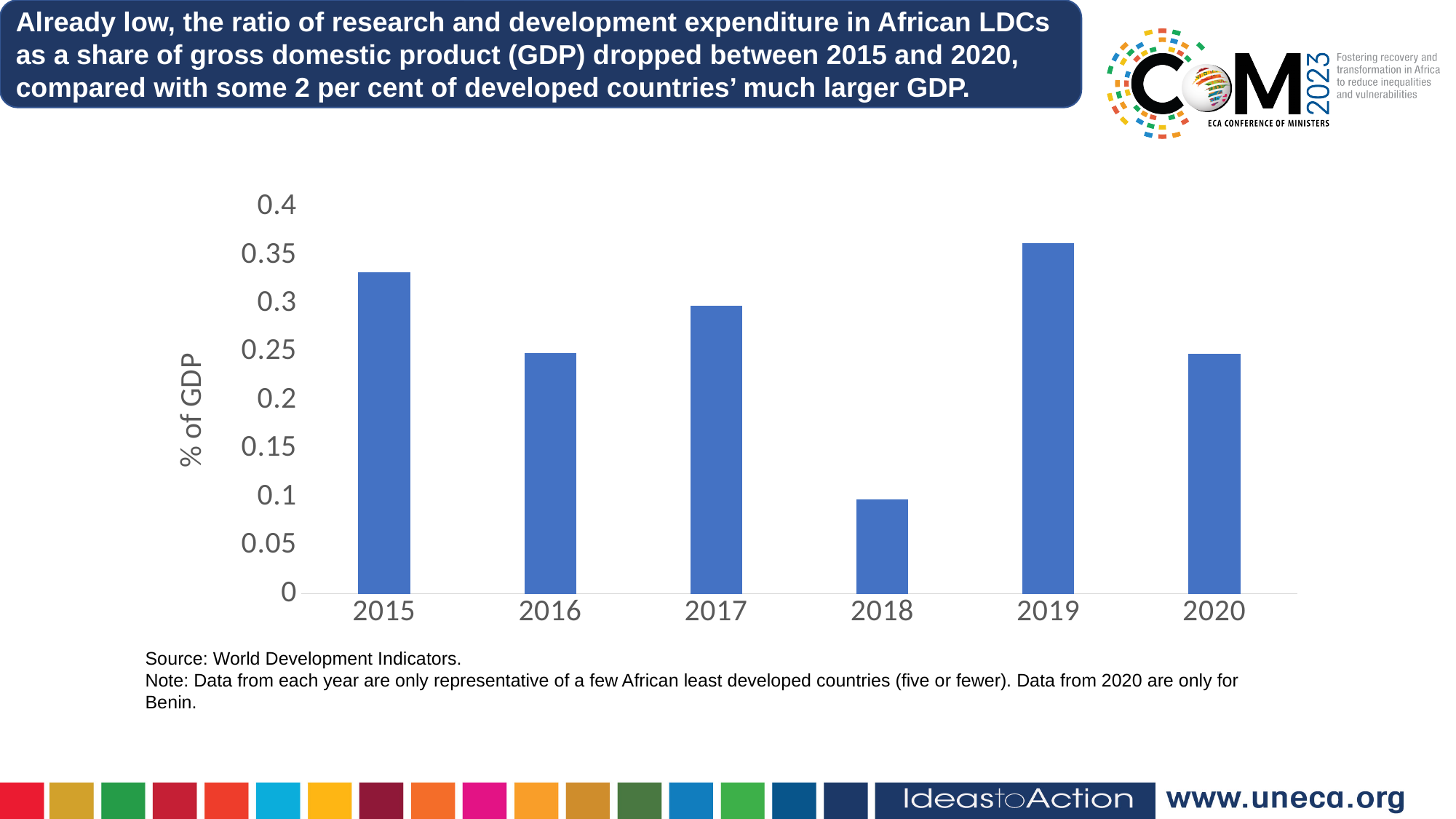
What source is cited below the chart? World Development Indicators Which year has the highest research and development expenditure as a share of GDP? 2019 Is the value for 2020 greater or less than 0.3? less Is the value for 2017 greater or less than 0.25? greater What kind of chart is shown on the slide? bar chart How many years are plotted on the x axis of the chart? 6 Which year has the larger value, 2017 or 2018? 2017 Is the value for 2018 greater or less than 0.15? less What is the label on the vertical axis of the chart? % of GDP Which year has the larger value, 2015 or 2016? 2015 Which year has the lowest research and development expenditure as a share of GDP? 2018